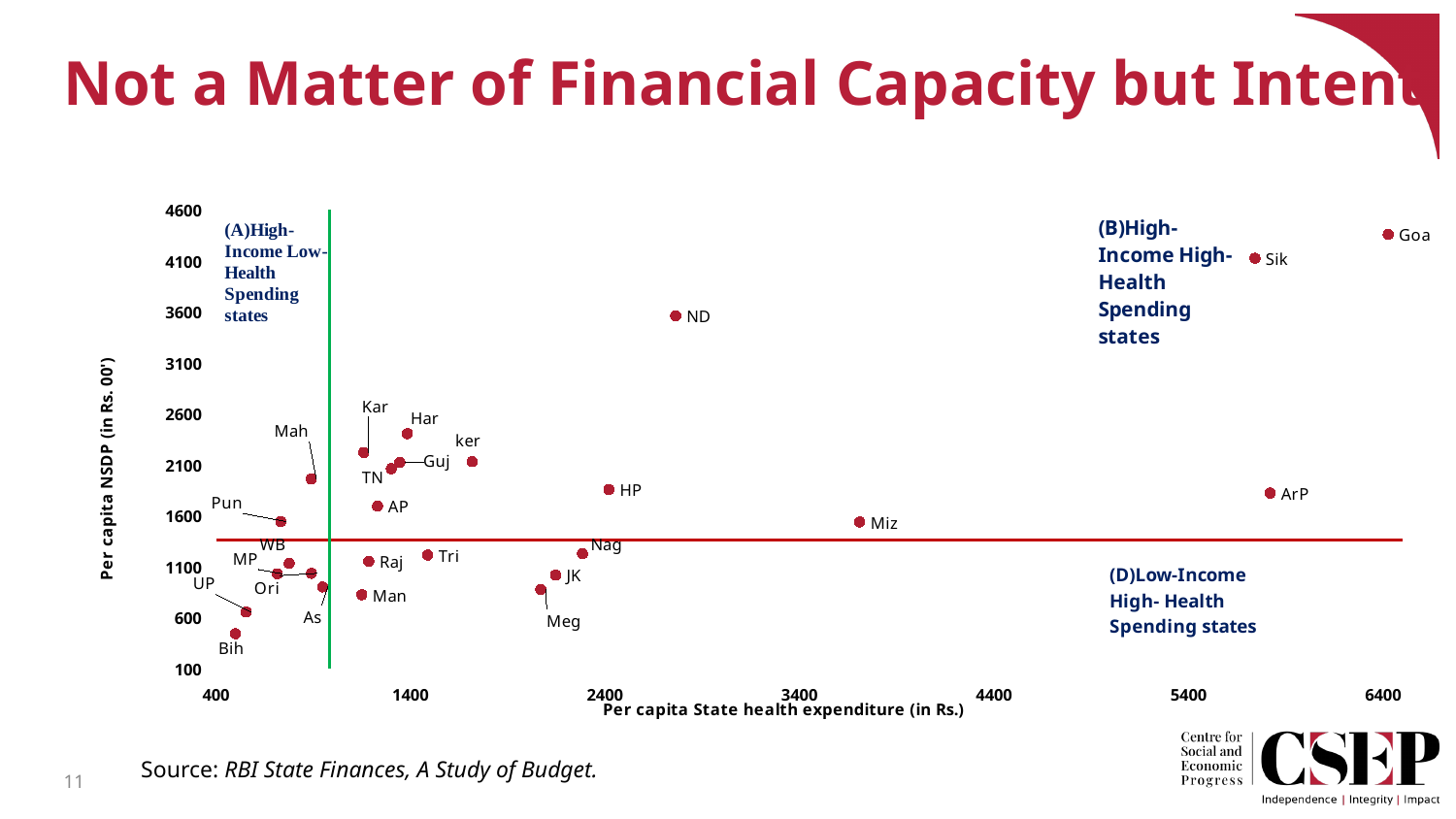
What kind of chart is shown on the slide? scatter chart Which state has a higher per capita State health expenditure, Miz or HP? Miz Is the per capita NSDP for Sik greater or less than 3600? greater Which state has the highest per capita State health expenditure on the chart? Goa Is the per capita State health expenditure for Miz greater or less than 3400? greater Which state has a higher per capita NSDP, Goa or Sik? Goa What is the label of the x axis of the chart? Per capita State health expenditure (in Rs.) Is the per capita State health expenditure for ArP greater or less than 5400? greater Which state has the highest per capita NSDP on the chart? Goa Which state has the lowest per capita NSDP on the chart? Bih